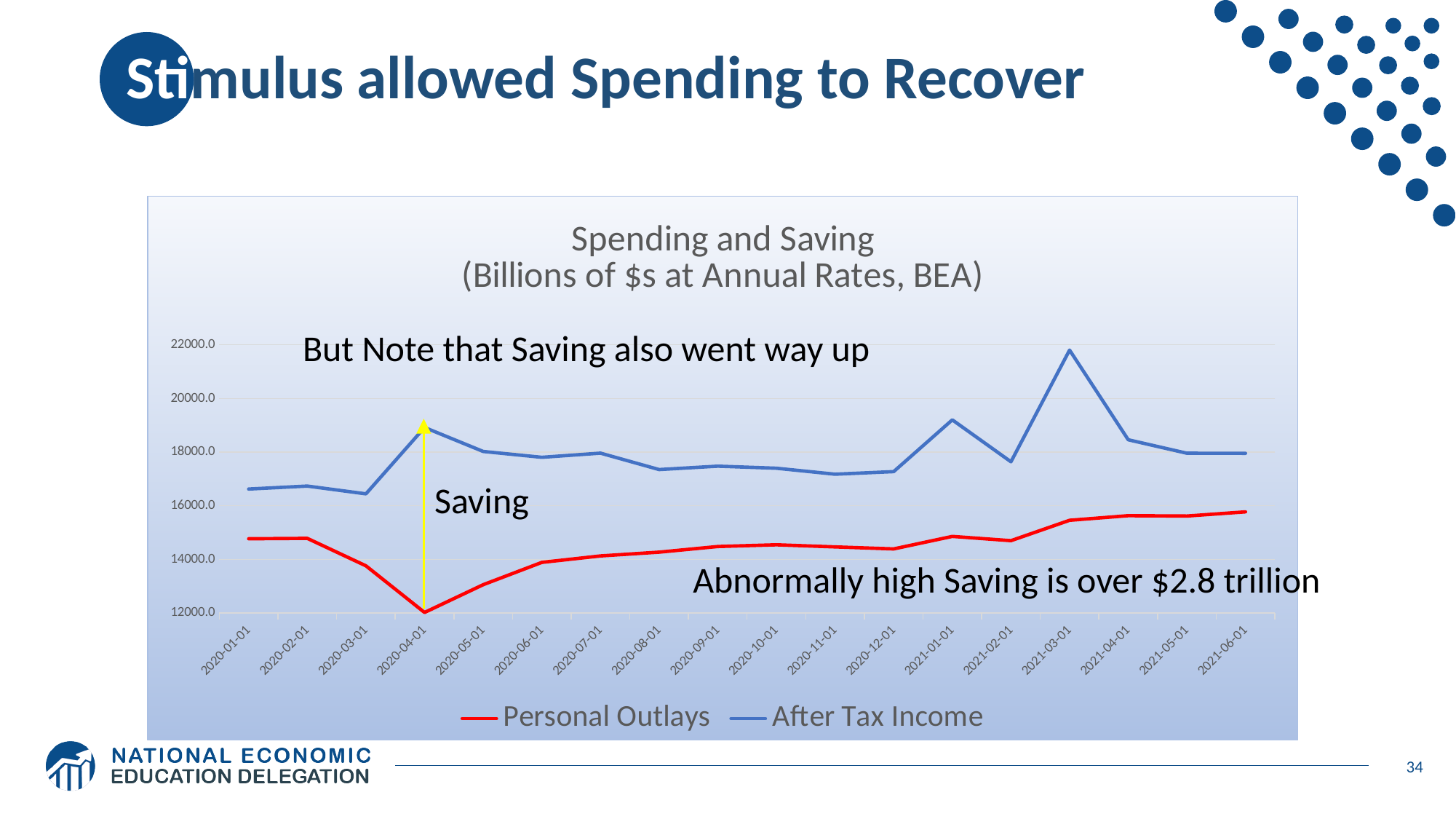
On which date does Personal Outlays reach its lowest value? 2020-04-01 Which series is drawn in red in the chart? Personal Outlays Is the value of After Tax Income on 2021-03-01 greater or less than 20000.0? greater How many dates are shown along the x axis of the chart? 18 How many series does the chart legend list? 2 Does Personal Outlays rise or fall from 2020-04-01 to 2021-06-01? rise What kind of chart is shown on the slide? line chart Is the value of After Tax Income on 2020-04-01 greater or less than 18000.0? greater Which series has the higher value on 2020-12-01, Personal Outlays or After Tax Income? After Tax Income Is the value of Personal Outlays on 2020-04-01 greater or less than 14000.0? less On which date does After Tax Income reach its highest value? 2021-03-01 What is the title of the chart? Spending and Saving (Billions of $s at Annual Rates, BEA)